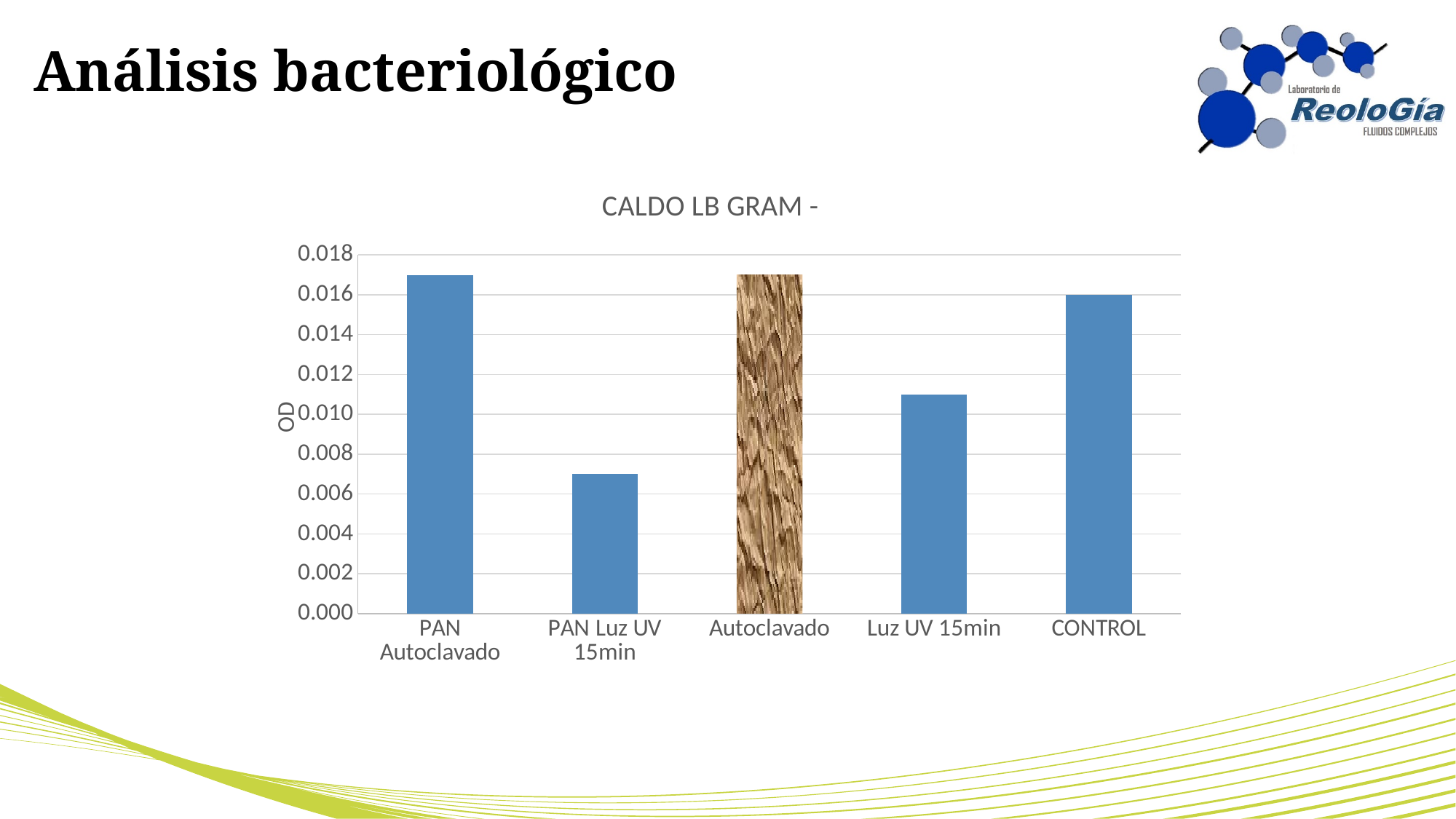
What kind of chart is shown on the slide? bar chart What is the label on the vertical axis of the chart? OD Is the OD value for PAN Luz UV 15min greater or less than 0.008? less Which has a higher OD value, Luz UV 15min or CONTROL? CONTROL What is the title of the chart? CALDO LB GRAM - Which has a lower OD value, PAN Luz UV 15min or Luz UV 15min? PAN Luz UV 15min Is the OD value for Autoclavado greater or less than 0.014? greater Which category has the lowest OD value? PAN Luz UV 15min Is the OD value for PAN Autoclavado greater or less than 0.016? greater How many categories are plotted on the x axis of the chart? 5 Which has a higher OD value, PAN Autoclavado or PAN Luz UV 15min? PAN Autoclavado